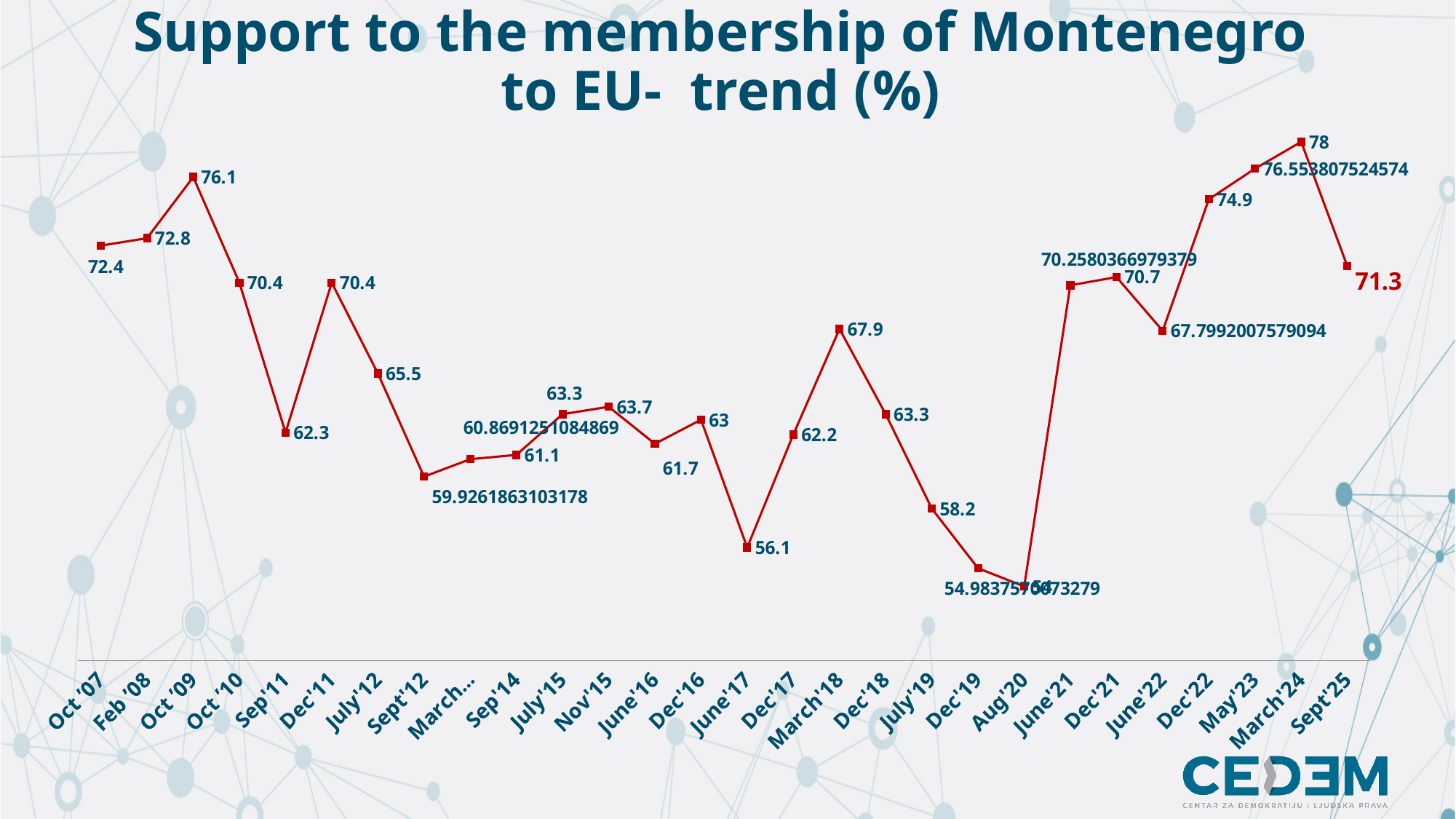
What is the value for March'18? 67.9 Which point has the highest value on the chart? March'24 What is the value for Oct '09? 76.1 What is the difference between the values for March'24 and Sept'25? 6.7 How many data points are plotted on the chart? 28 What is the difference between the values for Oct '09 and Oct '10? 5.7 What is the value for June'17? 56.1 Which is larger, the value for Dec'22 or the value for Dec'21? Dec'22 What is the value for Sept'25? 71.3 Do the values rise or fall from Dec'22 to March'24? rise What kind of chart is shown on the slide? line chart What is the title of the chart? Support to the membership of Montenegro to EU- trend (%)